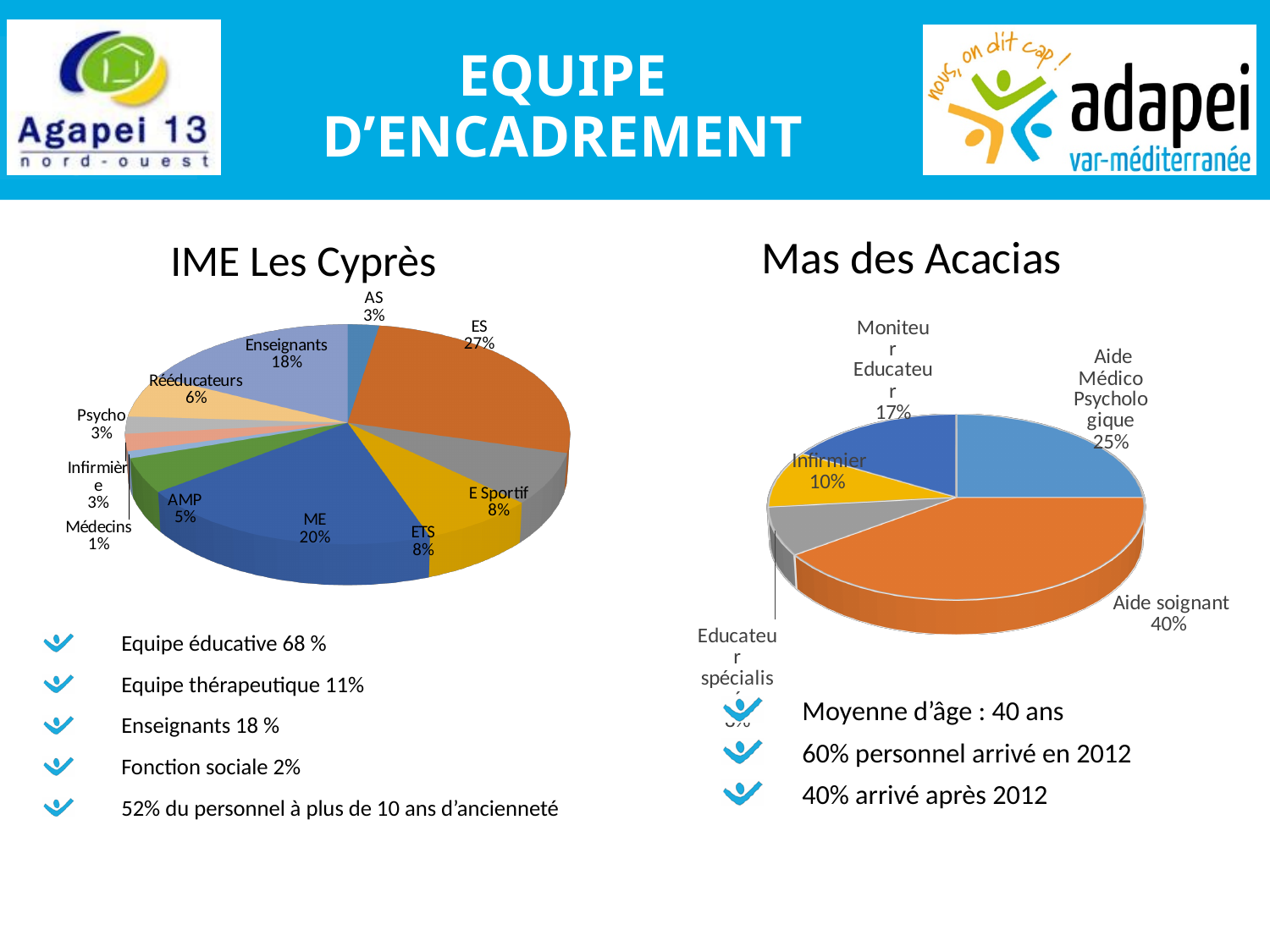
What kind of chart is used for Mas des Acacias? Pie chart In the IME Les Cyprès chart, what is the difference between the ES share and the ME share? 7% In the IME Les Cyprès chart, what percentage is shown for ME? 20% In the Mas des Acacias chart, what is the difference between Aide Médico Psychologique and Infirmier? 15% In the Mas des Acacias chart, what percentage is shown for Moniteur Educateur? 17% In the Mas des Acacias chart, what percentage is shown for Aide soignant? 40% In the IME Les Cyprès chart, what percentage is shown for ES? 27% In the IME Les Cyprès chart, which category has the smallest share? Médecins How many slices does the IME Les Cyprès pie chart have? 11 In the IME Les Cyprès chart, which category has the largest share? ES In the IME Les Cyprès chart, which is larger, AMP or Rééducateurs? Rééducateurs In the IME Les Cyprès chart, what percentage is shown for Enseignants? 18%